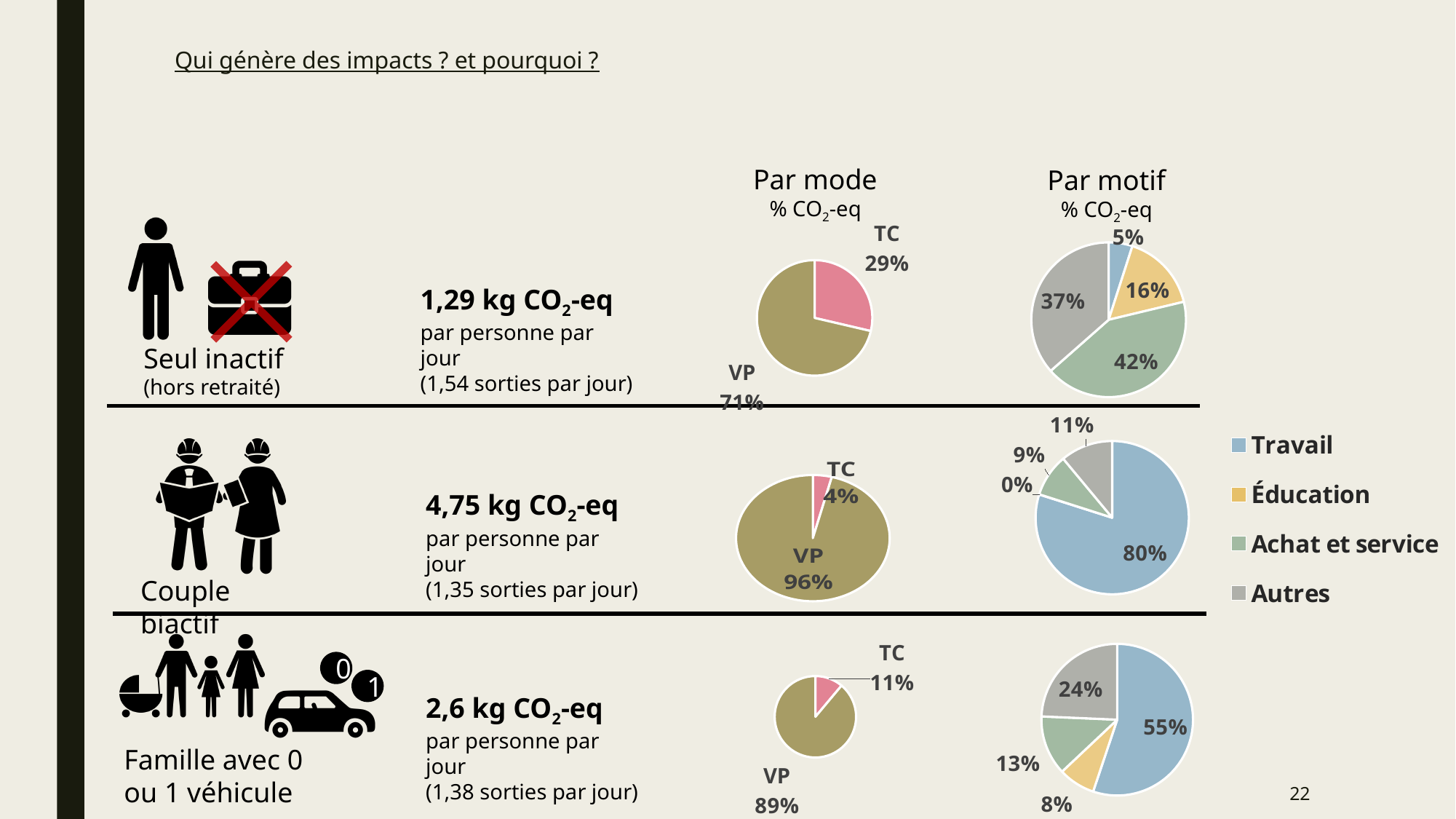
In the 'Par mode' pie chart for 'Seul inactif', what share is TC? 29% What type of chart is used for the 'Par mode' and 'Par motif' breakdowns? Pie chart In the 'Par mode' pie chart for 'Couple biactif', what share is VP? 96% In the 'Par motif' pie chart for 'Seul inactif', what share is 'Achat et service'? 42% In the 'Par motif' pie chart for 'Couple biactif', which category has the smallest share? Éducation In the 'Par mode' pie chart for 'Famille avec 0 ou 1 véhicule', what share is TC? 11% In the 'Par motif' pie chart for 'Seul inactif', which category has the largest share? Achat et service In the 'Par motif' pie chart for 'Famille avec 0 ou 1 véhicule', what share is 'Autres'? 24% In the 'Par motif' pie chart for 'Couple biactif', what share is 'Travail'? 80% How many categories does the 'Par motif' legend list? 4 In the 'Par motif' pie chart for 'Seul inactif', which is larger: 'Éducation' or 'Autres'? Autres In the 'Par motif' pie chart for 'Famille avec 0 ou 1 véhicule', what is the difference between the 'Travail' share and the 'Autres' share? 31%